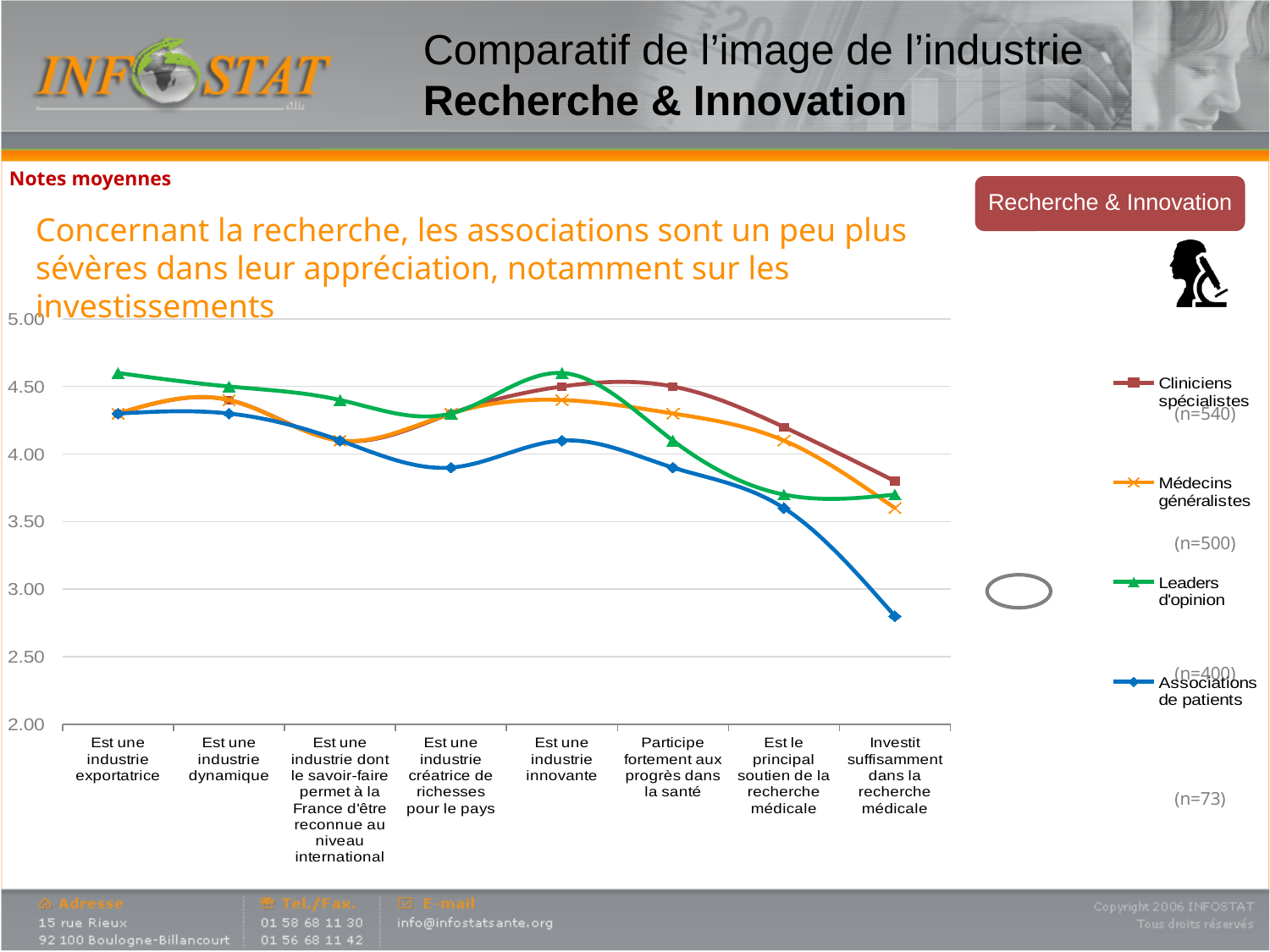
How many categories are shown along the x axis? 8 Is the value for Associations de patients on "Est une industrie créatrice de richesses pour le pays" greater or less than 4.00? less Which series has the lowest value for "Investit suffisamment dans la recherche médicale"? Associations de patients Is the value for Cliniciens spécialistes on "Est le principal soutien de la recherche médicale" greater or less than 4.00? greater Is the value for Associations de patients on "Investit suffisamment dans la recherche médicale" greater or less than 3.00? less How many series does the legend list? 4 Does the Associations de patients line rise or fall from "Est le principal soutien de la recherche médicale" to "Investit suffisamment dans la recherche médicale"? fall For "Investit suffisamment dans la recherche médicale", which is higher: Cliniciens spécialistes or Associations de patients? Cliniciens spécialistes What sample size (n) is shown in the legend for Cliniciens spécialistes? n=540 Which series has the highest value for "Est une industrie exportatrice"? Leaders d'opinion What kind of chart is shown on the slide? line chart What sample size (n) is shown in the legend for Associations de patients? n=73